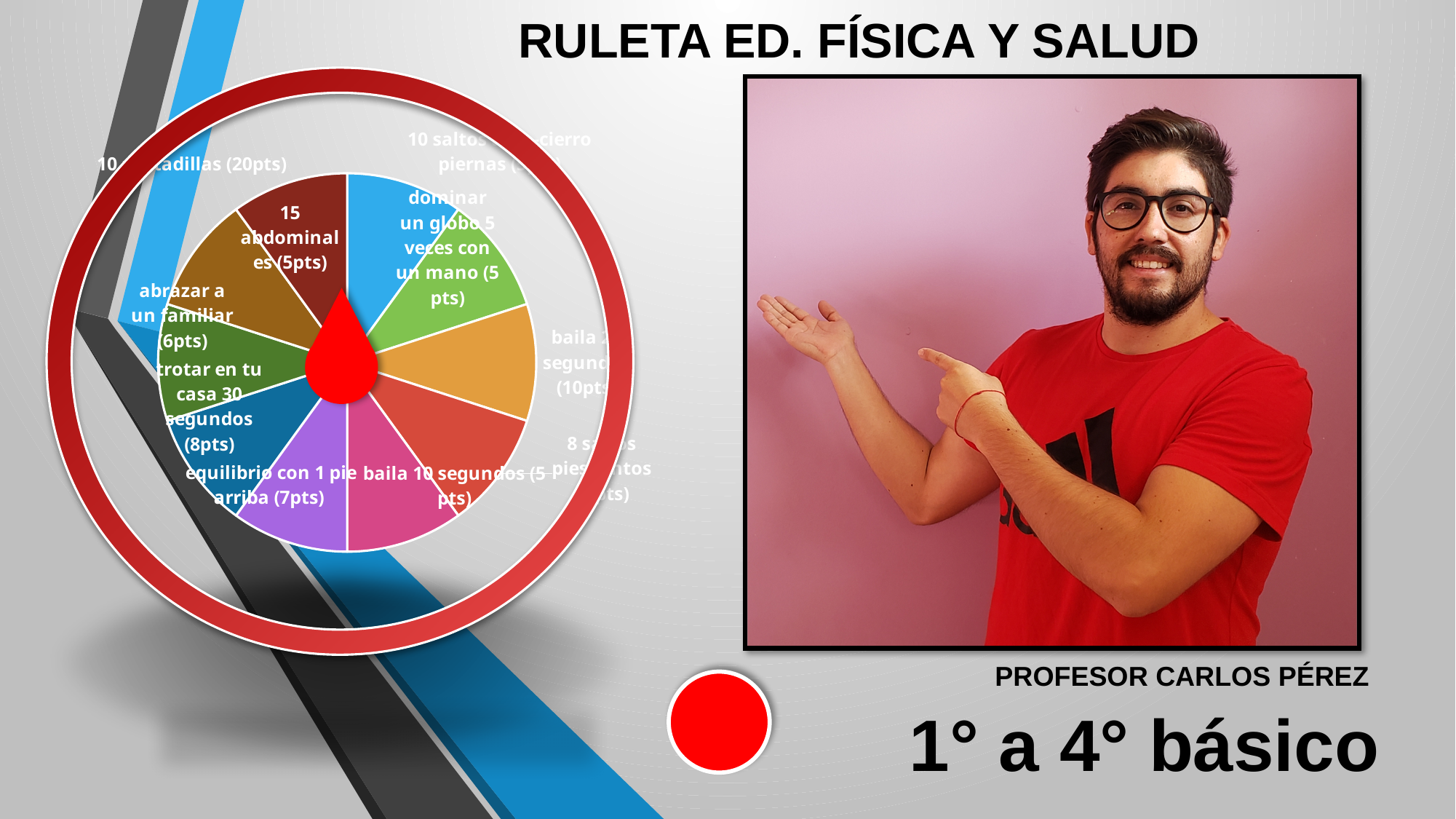
What colour is the slice labelled "15 abdominales (5pts)"? dark red How many points is "baila 10 segundos" worth on the wheel? 5 pts How many points is the "15 abdominales" activity worth on the wheel? 5pts How many points is "equilibrio con 1 pie arriba" worth on the wheel? 7pts How many points is "trotar en tu casa 30 segundos" worth on the wheel? 8pts How many points is "abrazar a un familiar" worth on the wheel? 6pts What is the title shown at the top of the slide above the wheel? RULETA ED. FÍSICA Y SALUD Which is worth more points on the wheel, "trotar en tu casa 30 segundos" or "equilibrio con 1 pie arriba"? trotar en tu casa 30 segundos How many points is "dominar un globo 5 veces con un mano" worth on the wheel? 5 pts What kind of chart is the roulette wheel on the left of the slide? pie chart What is the difference in points between "trotar en tu casa 30 segundos" and "equilibrio con 1 pie arriba"? 1 How many slices does the roulette wheel have? 10